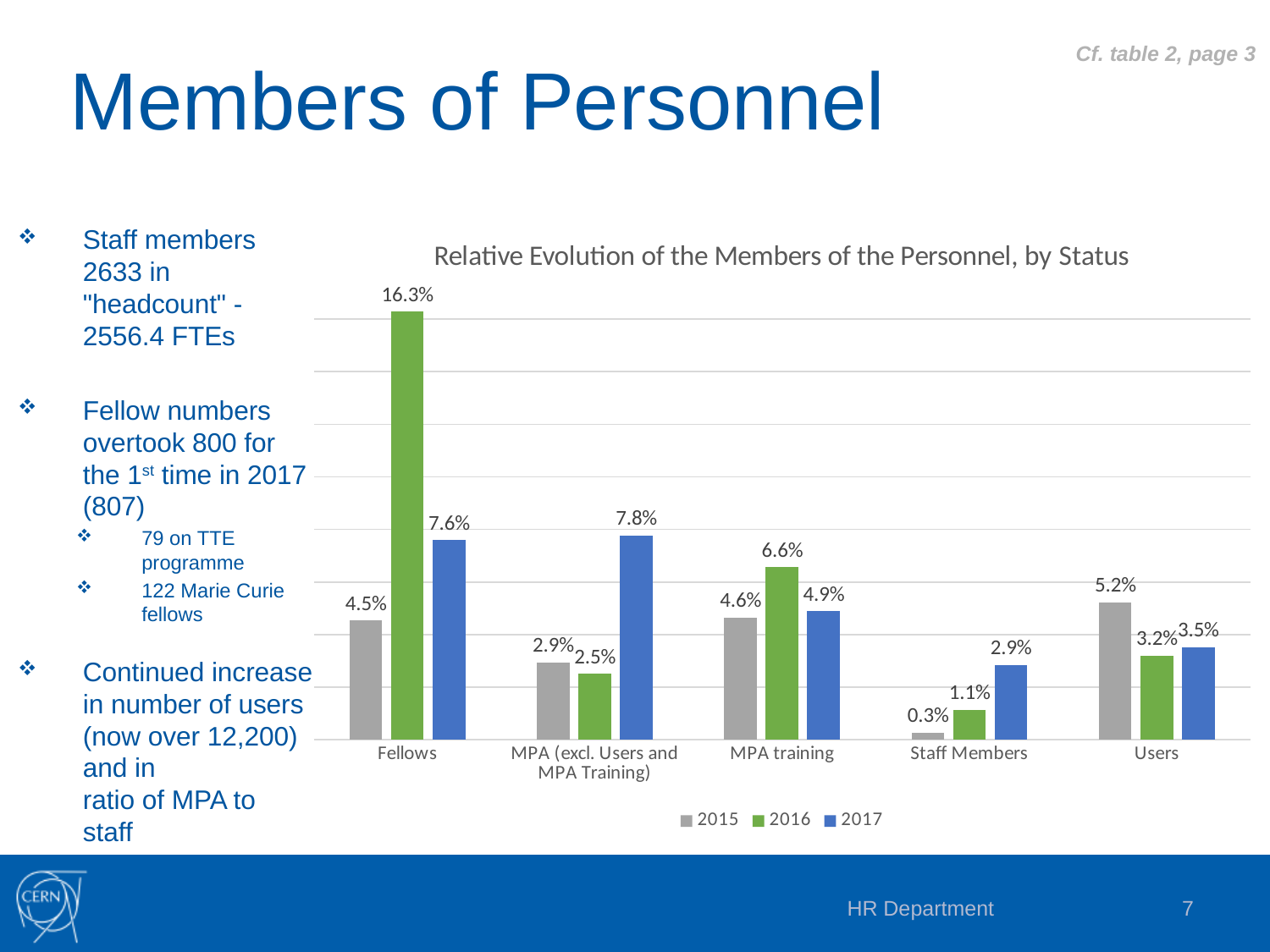
What is the 2017 value for MPA (excl. Users and MPA Training)? 7.8% How many series does the legend list? 3 What kind of chart is shown? Bar chart How many categories are shown on the x axis? 5 What is the 2015 value for Staff Members? 0.3% What is the difference between the 2016 and 2017 values for Fellows? 8.7% What is the 2016 value for Fellows? 16.3% Which category has the lowest 2015 value? Staff Members Which category has the highest 2016 value? Fellows What is the title of the chart? Relative Evolution of the Members of the Personnel, by Status Which is larger for MPA training: the 2015 value or the 2016 value? 2016 What is the 2015 value for Users? 5.2%